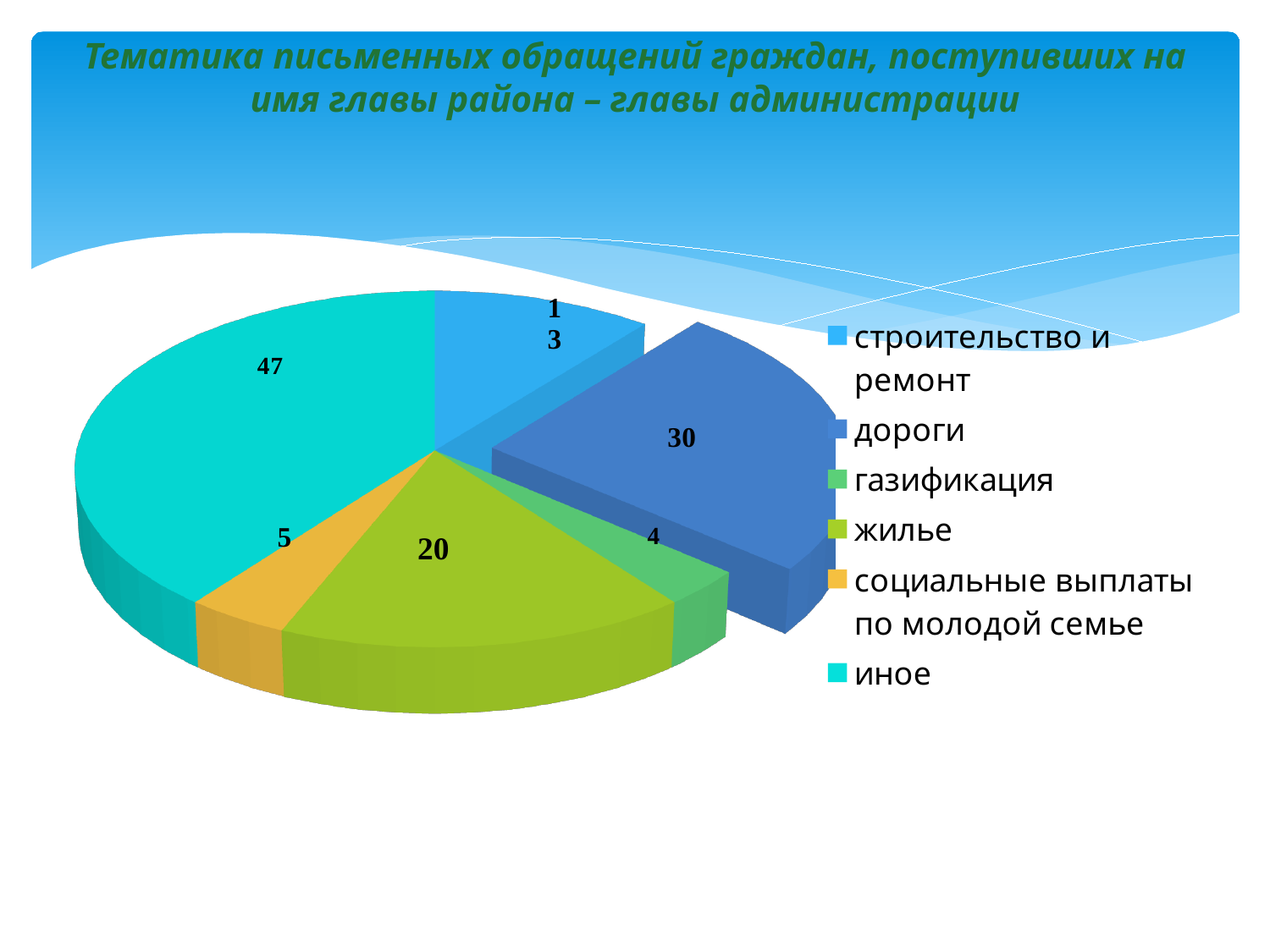
What is the value for газификация? 4 What is the value for дороги? 30 Which category is shown in the exploded (pulled-out) slice? дороги What is the difference between the values for иное and дороги? 17 How many categories does the legend list? 6 What is the value for жилье? 20 Which category has the largest slice? иное What type of chart is shown on the slide? pie chart Which is larger, the value for жилье or the value for дороги? дороги Which category has the smallest slice? газификация What is the value for социальные выплаты по молодой семье? 5 What is the value for иное? 47